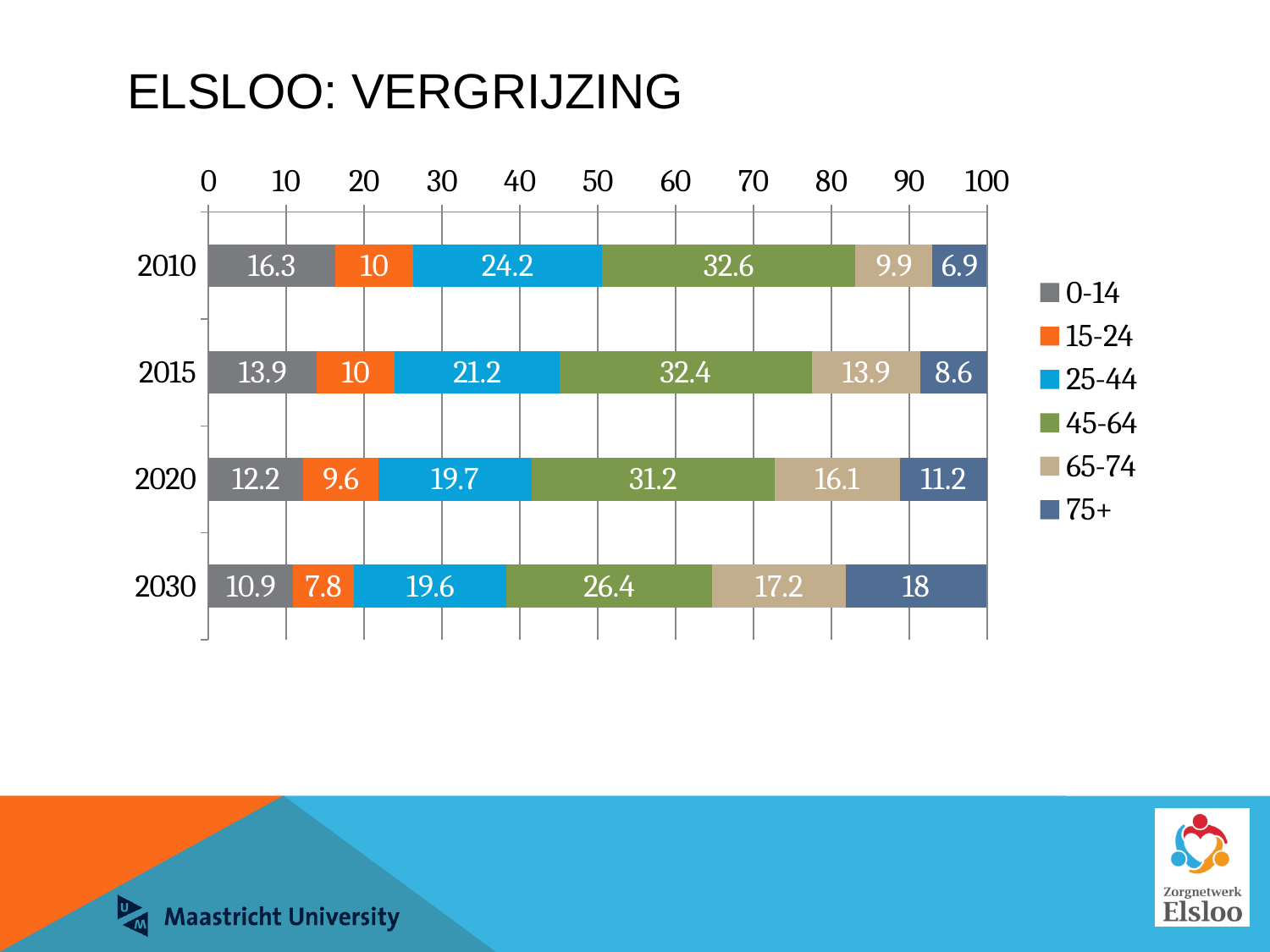
What is the value for the 0-14 series in 2010? 16.3 In which year is the 75+ series highest? 2030 What is the value for the 25-44 series in 2015? 21.2 How many years (categories) are shown on the chart? 4 What is the value for the 65-74 series in 2020? 16.1 Which is larger: the 65-74 value in 2015 or the 65-74 value in 2020? 2020 How many series does the legend list? 6 What is the value for the 75+ series in 2030? 18 Does the 0-14 series rise or fall from 2010 to 2030? Fall In which year is the 0-14 series lowest? 2030 What kind of chart is shown on the slide? Stacked bar chart What is the difference between the 45-64 value in 2010 and in 2030? 6.2